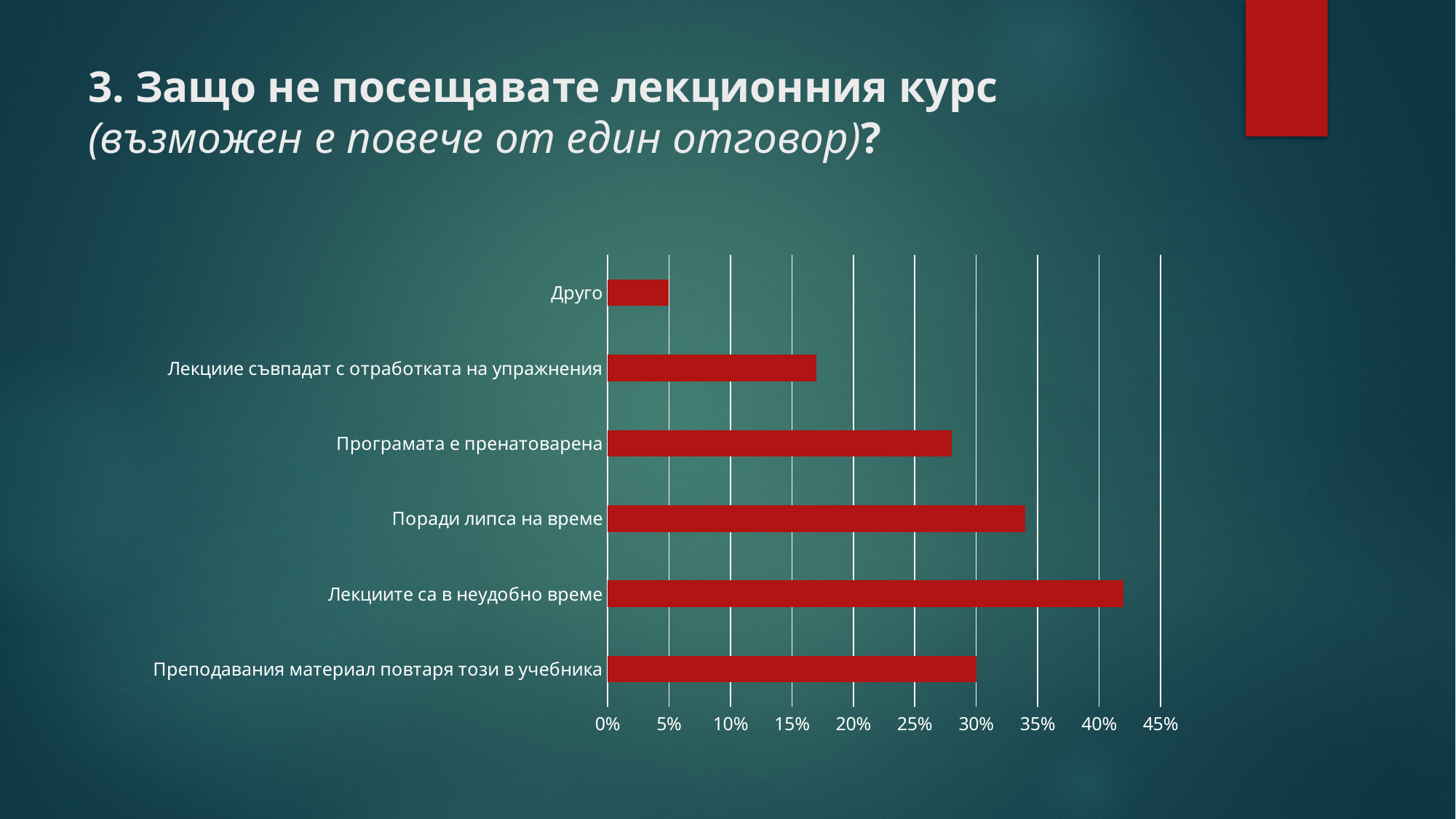
What is the value for "Друго"? 5% Which is larger: the value for "Поради липса на време" or the value for "Програмата е пренатоварена"? Поради липса на време What is the value for "Преподавания материал повтаря този в учебника"? 30% Is the value for "Лекциите са в неудобно време" greater or less than 40%? greater Is the value for "Лекциие съвпадат с отработката на упражнения" greater or less than 20%? less Is the value for "Програмата е пренатоварена" greater or less than 25%? greater Which reason has the highest value in the chart? Лекциите са в неудобно време What kind of chart is shown on the slide? bar chart What colour are the bars in the chart? red How many categories (reasons) are shown in the chart? 6 Which reason has the lowest value in the chart? Друго What is the highest value shown on the x axis of the chart? 45%